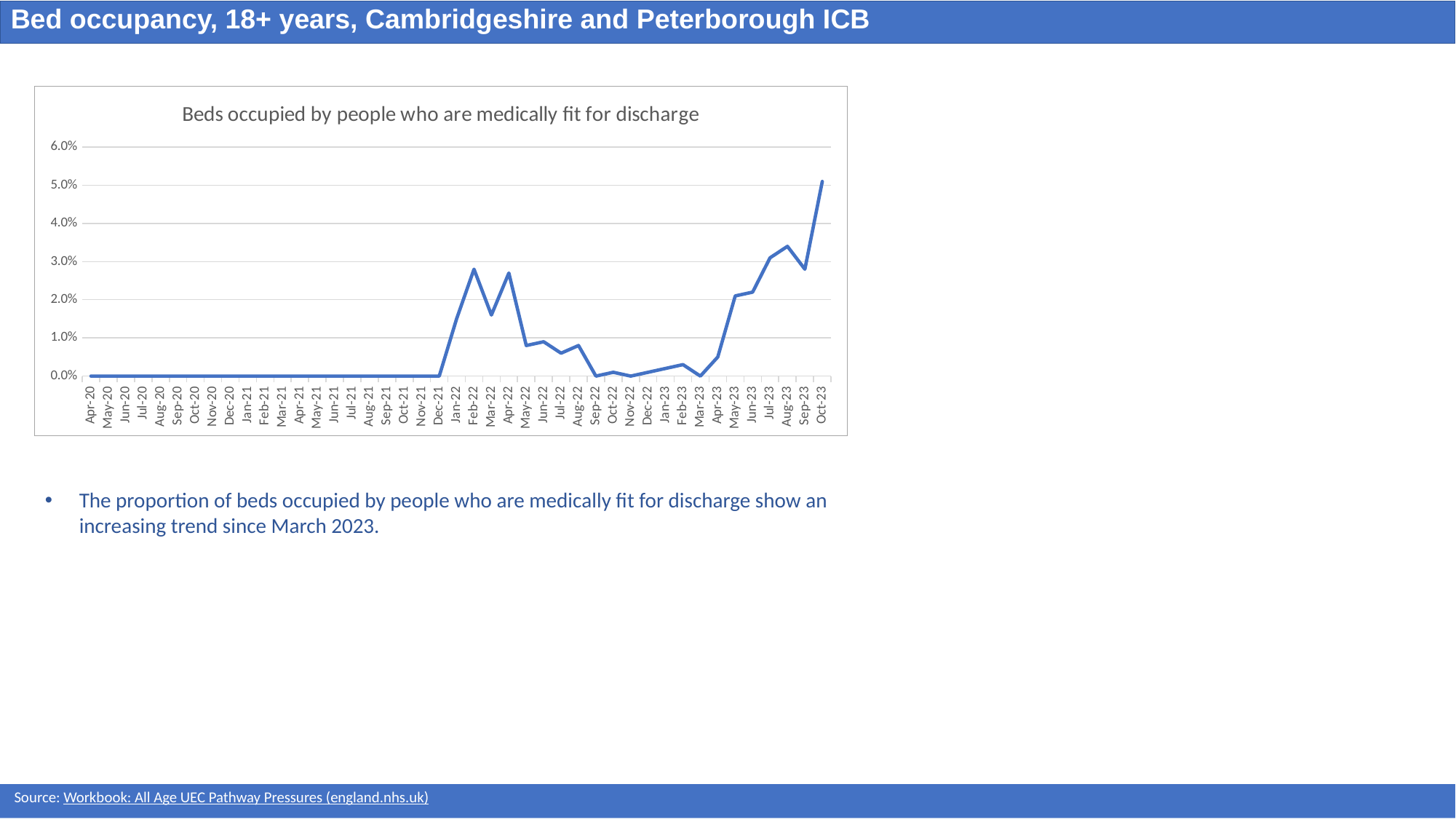
Which is larger, the value for Aug-23 or the value for Sep-23? Aug-23 Do the values rise or fall between Mar-23 and Aug-23? Rise Is the value for Feb-22 greater or less than 2.0%? greater Is the value for Aug-23 greater or less than 3.0%? greater Which month has the highest proportion of beds occupied by people who are medically fit for discharge? Oct-23 Is the value for Jul-22 greater or less than 1.0%? less How many monthly data points are plotted on the x axis? 43 What is the title of the chart? Beds occupied by people who are medically fit for discharge What kind of chart is shown on the slide? Line chart What is the value plotted for Jun-21? 0.0% Which is larger, the value for Feb-22 or the value for Mar-22? Feb-22